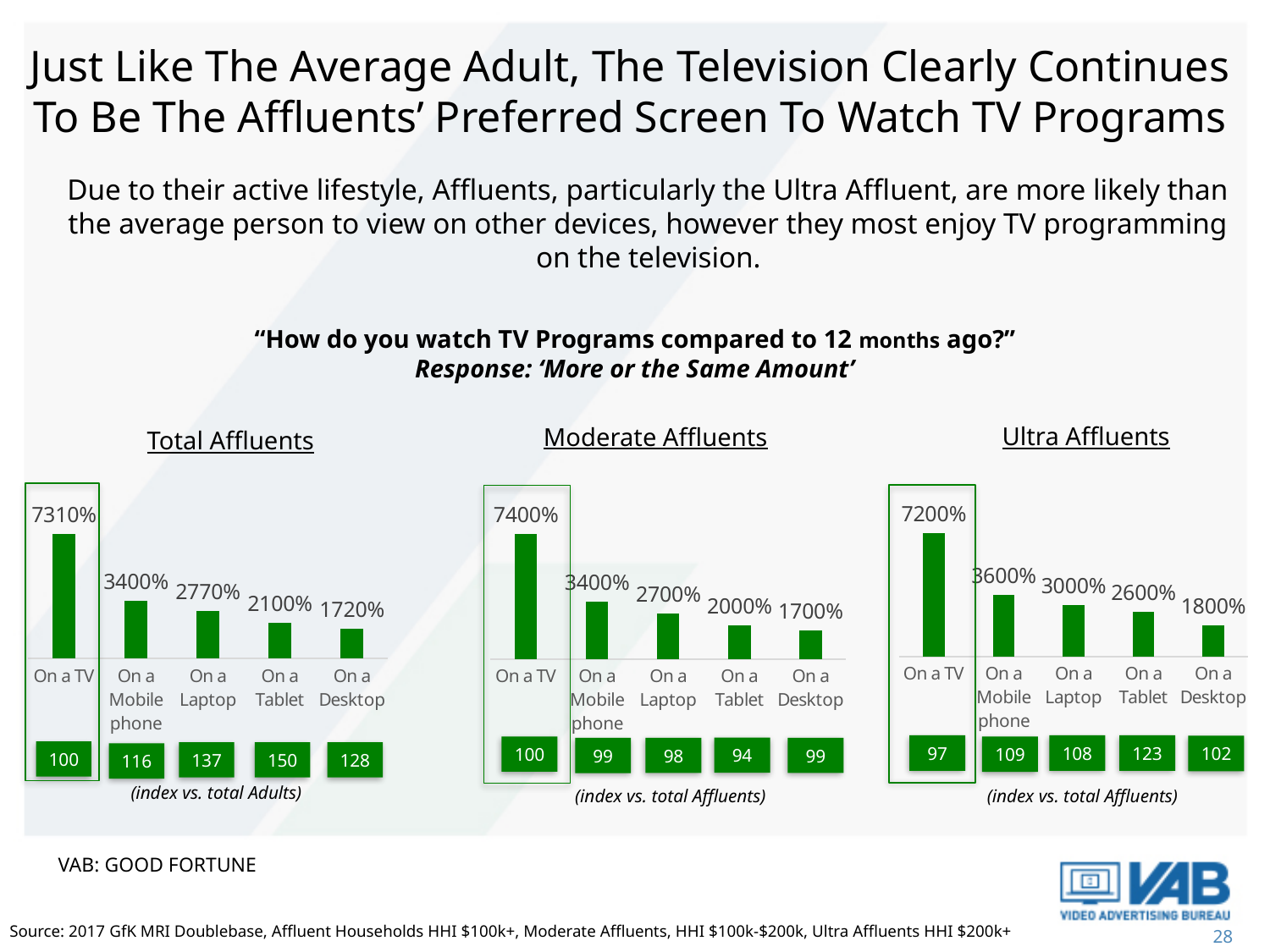
In the Total Affluents chart, what is the difference between the values for On a Mobile phone and On a Laptop? 630% What kind of chart is the Ultra Affluents chart? Bar chart In the Moderate Affluents chart, which category has the highest value? On a TV How many categories are shown in the Moderate Affluents chart? 5 How many charts are shown on the slide? 3 In the Total Affluents chart, what is the value for On a TV? 7310% In the Total Affluents chart, which is larger: the value for On a Tablet or the value for On a Desktop? On a Tablet In the Ultra Affluents chart, which category has the lowest value? On a Desktop In the Ultra Affluents chart, what is the difference between the values for On a TV and On a Tablet? 4600% In the Ultra Affluents chart, what is the value for On a Mobile phone? 3600% In the Total Affluents chart, do the values rise or fall from left to right across the categories? Fall In the Moderate Affluents chart, what is the value for On a Laptop? 2700%